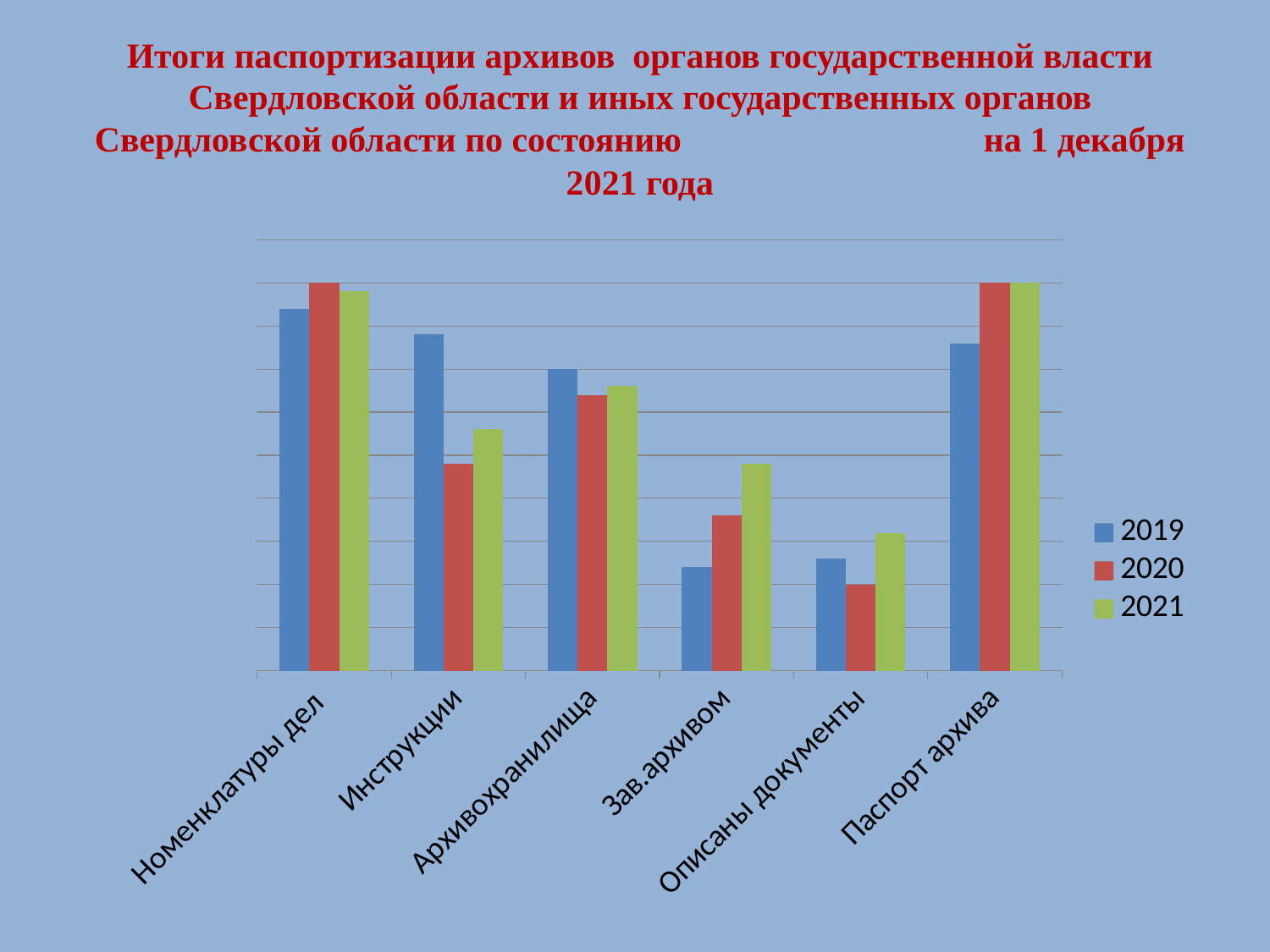
Which category has the lowest value for the 2020 series? Описаны документы For Зав.архивом, which is larger: the 2019 value or the 2021 value? 2021 Which colour represents the 2020 series in the chart? Red What kind of chart is shown on the slide? Bar chart Which years are listed in the chart's legend? 2019, 2020, 2021 Which category has the highest value for the 2019 series? Номенклатуры дел For Инструкции, which is larger: the 2019 value or the 2020 value? 2019 How many categories are shown along the x axis of the chart? 6 Which category has the lowest value for the 2019 series? Зав.архивом For Зав.архивом, do the values rise or fall from 2019 to 2021? Rise Which category has the lowest value for the 2021 series? Описаны документы How many series does the chart's legend list? 3